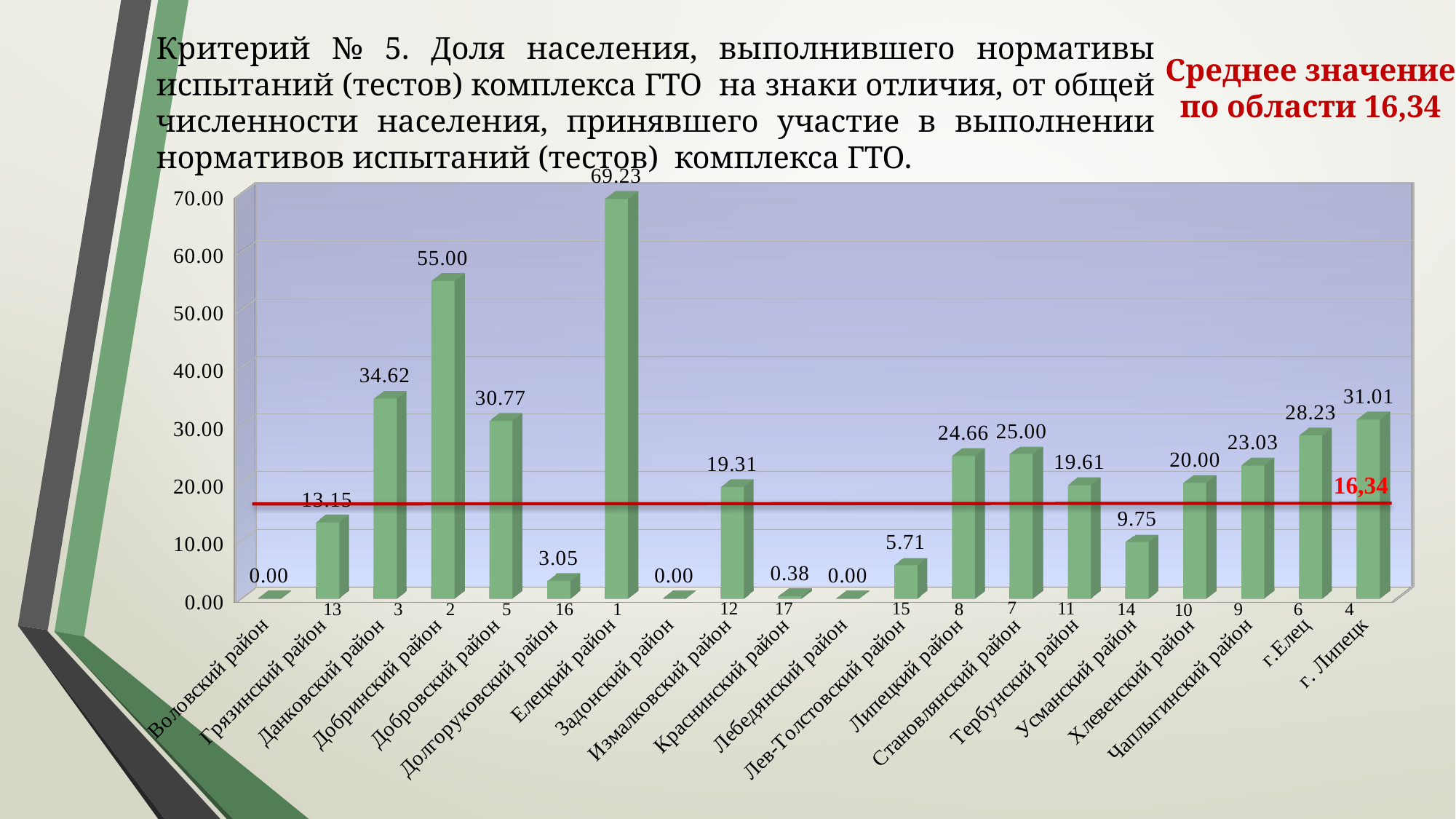
How many categories are shown on the x axis? 20 What is the difference between the values for г. Липецк and г.Елец? 2.78 What is the value for г. Липецк? 31.01 What is the value for Елецкий район? 69.23 Which is larger, the value for Данковский район or the value for Добровский район? Данковский район What is the difference between the values for Елецкий район and Добринский район? 14.23 What kind of chart is shown on the slide? bar chart Which category has the highest value? Елецкий район What value does the red horizontal line on the chart mark? 16,34 How many categories have a value of 0.00? 3 What is the value for Усманский район? 9.75 What is the value for Добринский район? 55.00